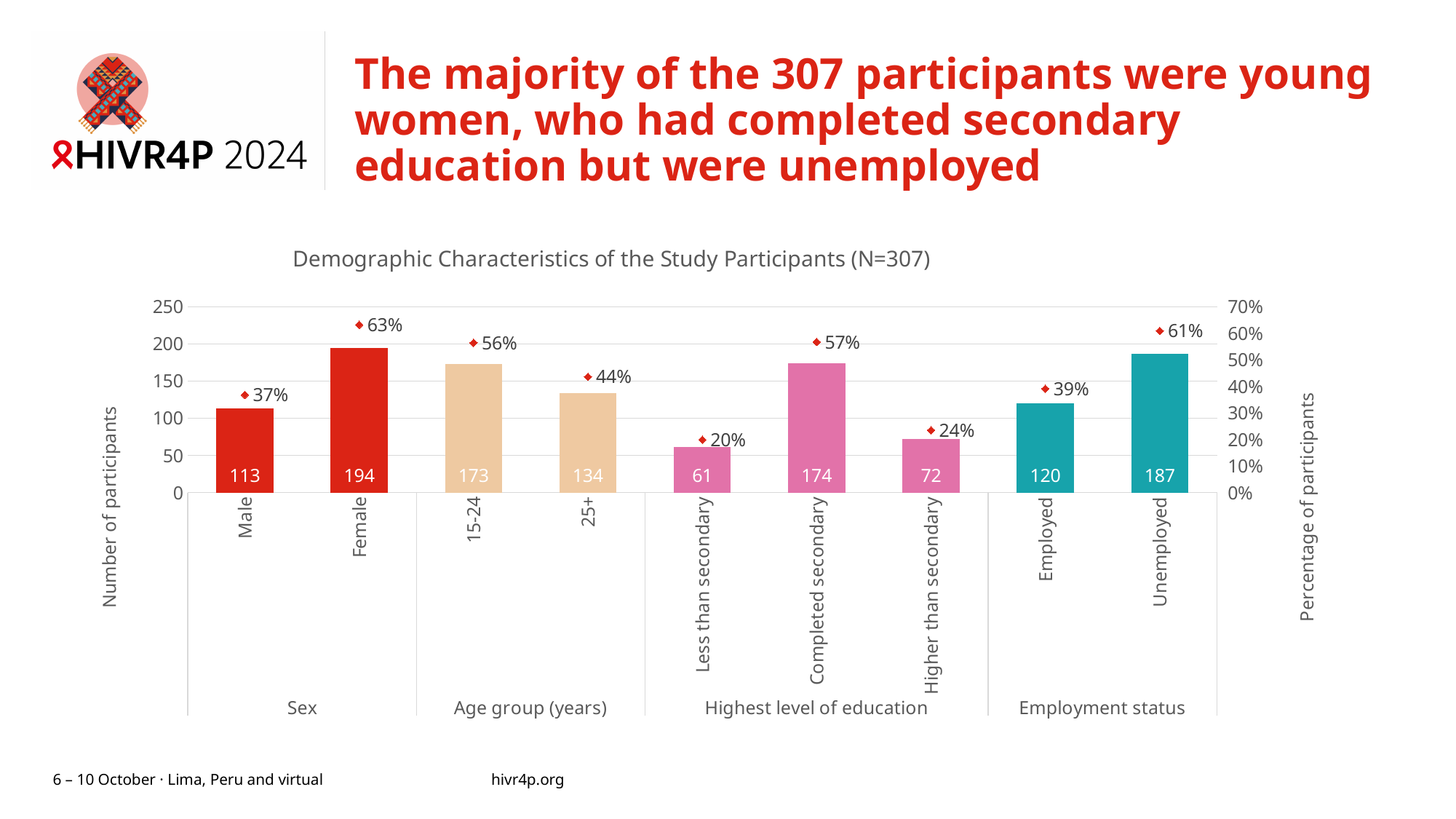
What is the difference in number of participants between Unemployed and Employed? 67 What percentage of participants are in the 15-24 age group? 56% How many participants had completed secondary education? 174 Which category has the highest number of participants? Female What is the title of the chart? Demographic Characteristics of the Study Participants (N=307) What is the difference in number of participants between Female and Male? 81 Which category has the lowest number of participants? Less than secondary Which has more participants, 15-24 or 25+? 15-24 What is the number of participants for Female? 194 What percentage of participants are Unemployed? 61% What kind of chart is this? Combination bar and line chart (bars with percentage markers) How many categories are plotted on the x axis? 9